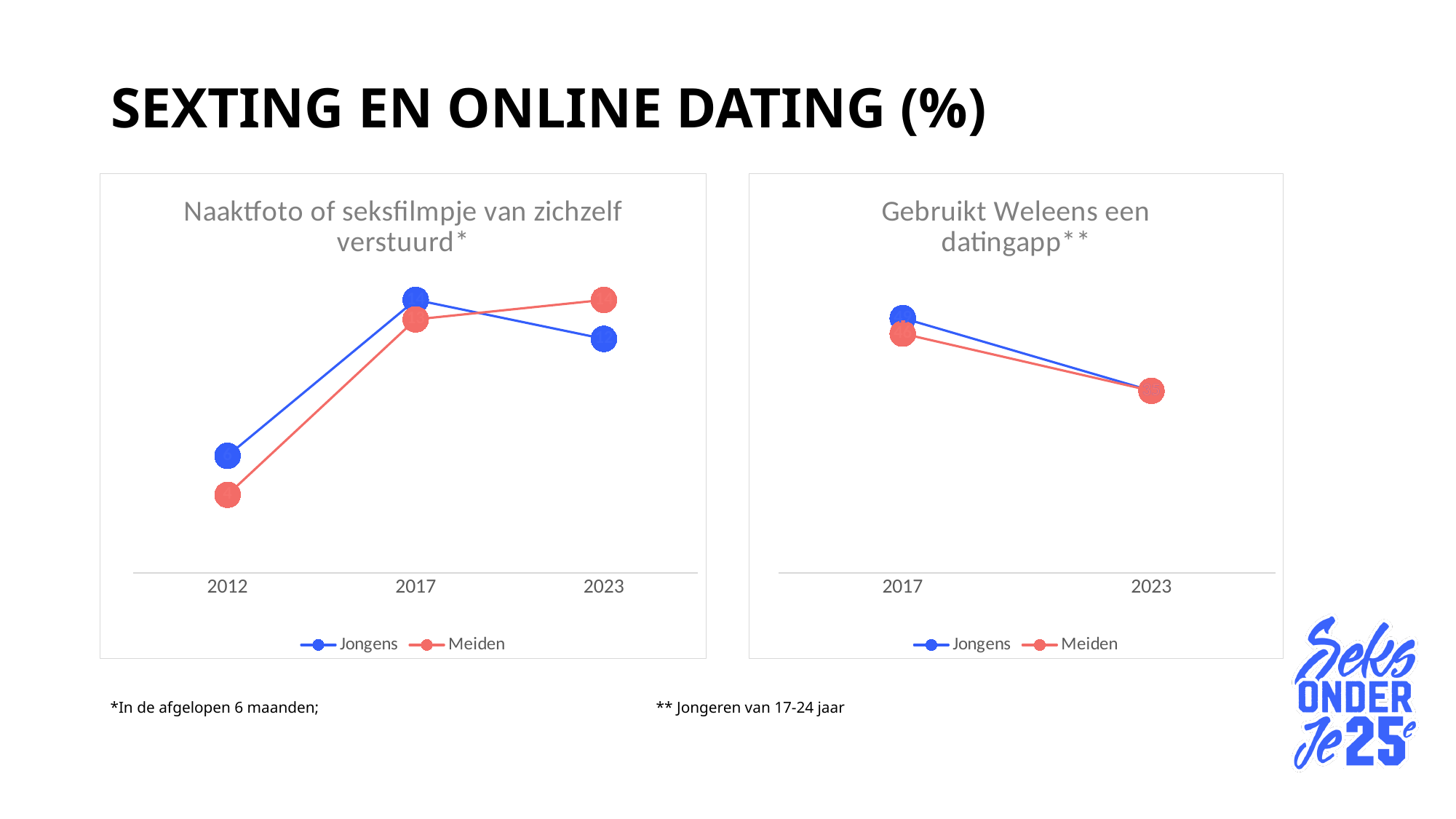
In the left chart, 'Naaktfoto of seksfilmpje van zichzelf verstuurd', which series has the higher value in 2012, Jongens or Meiden? Jongens In the left chart, 'Naaktfoto of seksfilmpje van zichzelf verstuurd', in which year is the Meiden value lowest? 2012 In the left chart, 'Naaktfoto of seksfilmpje van zichzelf verstuurd', does the Meiden value rise or fall from 2012 to 2023? Rise In the right chart, 'Gebruikt Weleens een datingapp', how many years are shown on the x axis? 2 What kind of chart is the right chart, 'Gebruikt Weleens een datingapp'? Line chart In the left chart, 'Naaktfoto of seksfilmpje van zichzelf verstuurd', how many years are shown on the x axis? 3 What colour is the Meiden series in the right chart, 'Gebruikt Weleens een datingapp'? Red What kind of chart is the left chart, 'Naaktfoto of seksfilmpje van zichzelf verstuurd'? Line chart How many series does the legend of the left chart, 'Naaktfoto of seksfilmpje van zichzelf verstuurd', list? 2 In the left chart, 'Naaktfoto of seksfilmpje van zichzelf verstuurd', in which year is the Jongens value highest? 2017 In the right chart, 'Gebruikt Weleens een datingapp', does the Jongens value rise or fall from 2017 to 2023? Fall In the left chart, 'Naaktfoto of seksfilmpje van zichzelf verstuurd', which series has the higher value in 2023, Jongens or Meiden? Meiden